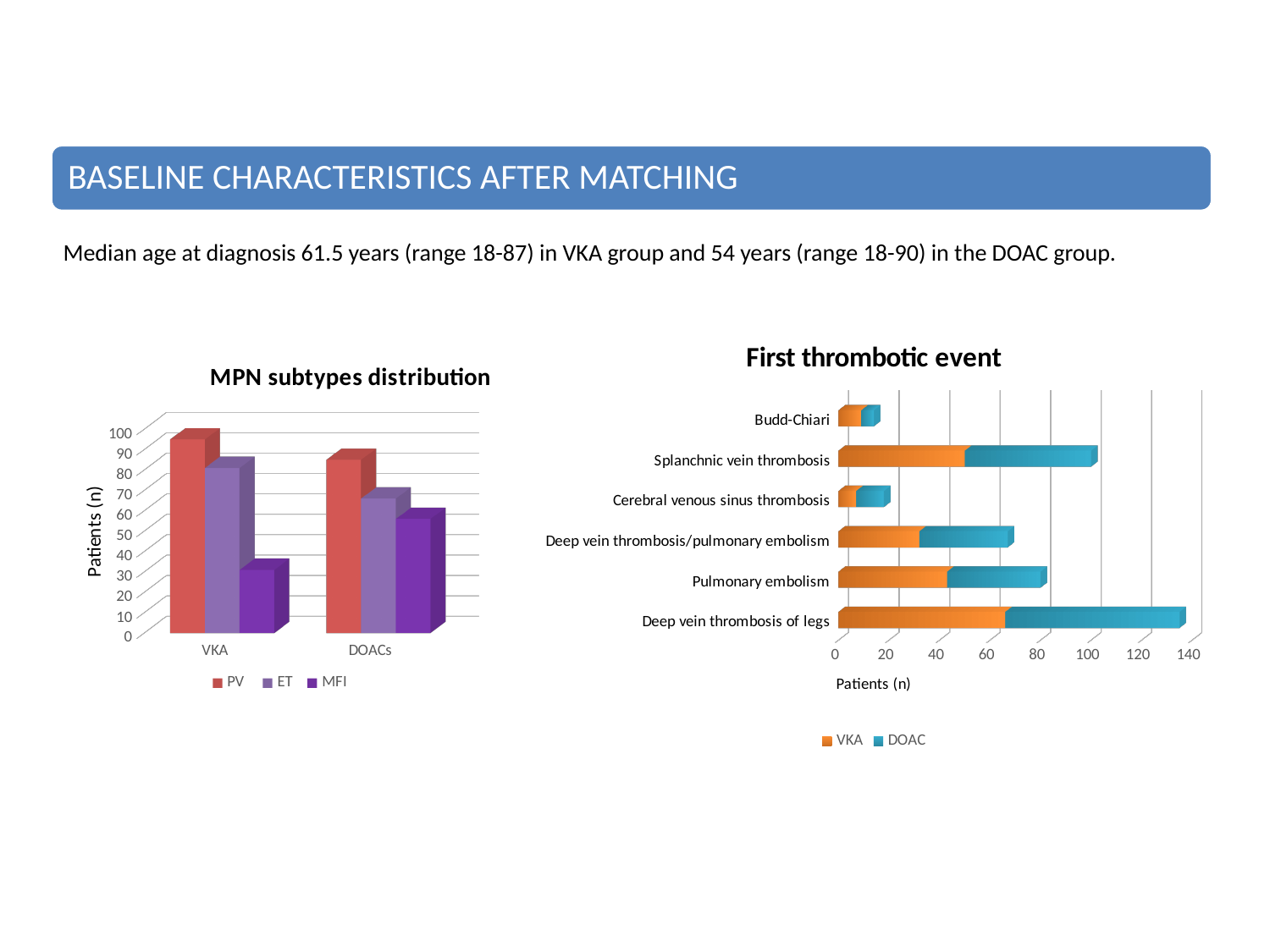
In the "MPN subtypes distribution" chart, which subtype has the lowest value in the VKA group? MFI In the "MPN subtypes distribution" chart, which subtype has the highest value in the VKA group? PV How many categories are shown on the x axis of the "MPN subtypes distribution" chart? 2 How many series does the legend of the "MPN subtypes distribution" chart list? 3 How many series does the legend of the "First thrombotic event" chart list? 2 In the "MPN subtypes distribution" chart, is the MFI value for VKA greater or less than 40? less What kind of chart is the "MPN subtypes distribution" chart? bar chart How many categories are shown in the "First thrombotic event" chart? 6 In the "First thrombotic event" chart, which category has the longest total bar? Deep vein thrombosis of legs In the "MPN subtypes distribution" chart, is the MFI value larger for VKA or for DOACs? DOACs In the "First thrombotic event" chart, is the total for Deep vein thrombosis of legs greater or less than 120? greater In the "MPN subtypes distribution" chart, is the PV value for VKA greater or less than 90? greater